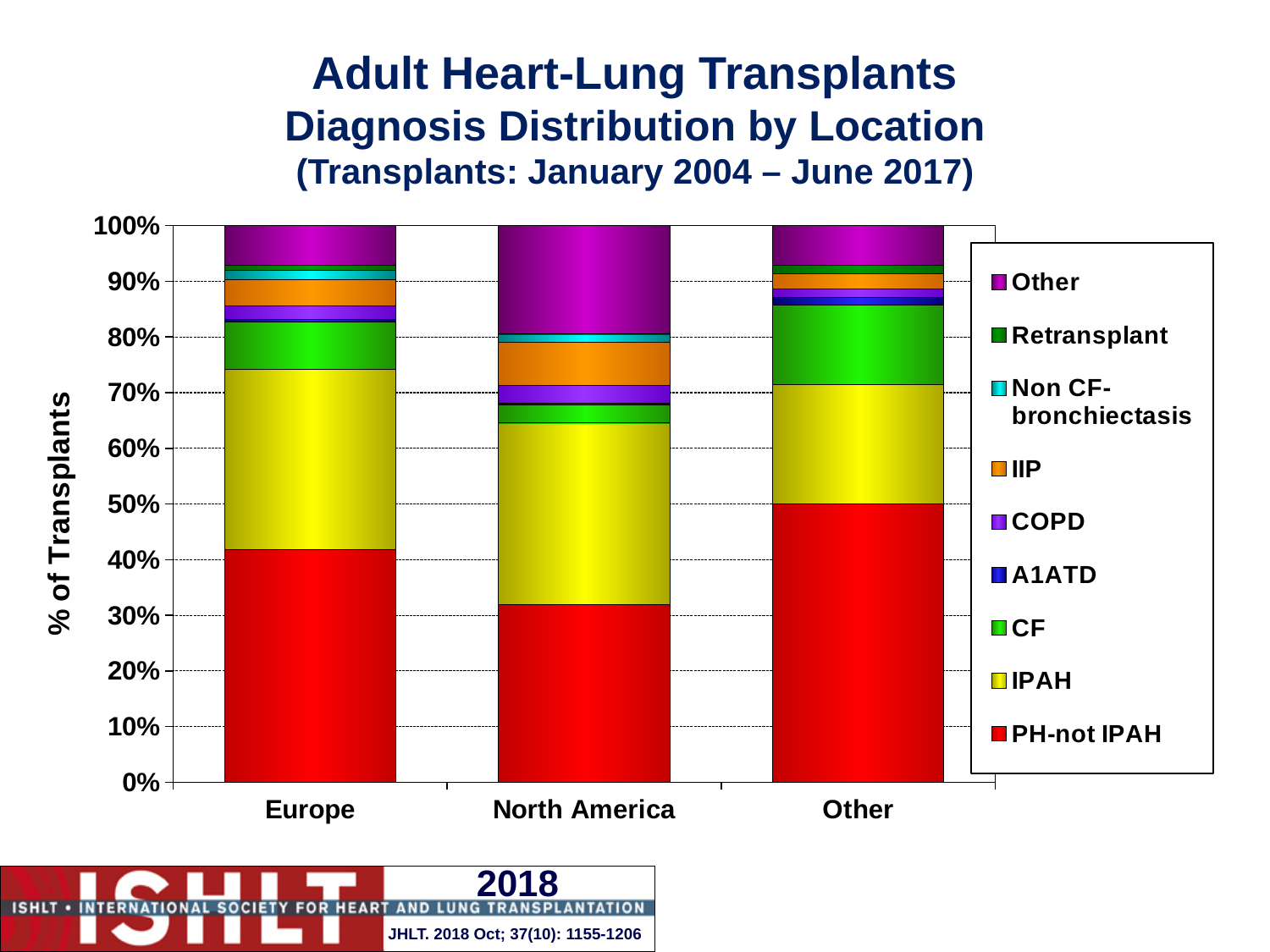
How many diagnosis series does the legend list? 9 Which location has the smallest PH-not IPAH share? North America Is the PH-not IPAH share for Other greater or less than 60%? less Is the PH-not IPAH share for Europe greater or less than 40%? greater Which location has the largest PH-not IPAH share? Other What kind of chart is shown on the slide? stacked bar chart How many locations (categories) are shown on the x axis? 3 Which location has the largest 'Other' diagnosis segment? North America Is the PH-not IPAH share larger for Europe or for North America? Europe What is the label on the y axis? % of Transplants Which location has the smallest IPAH segment? Other Is the PH-not IPAH share for North America greater or less than 40%? less